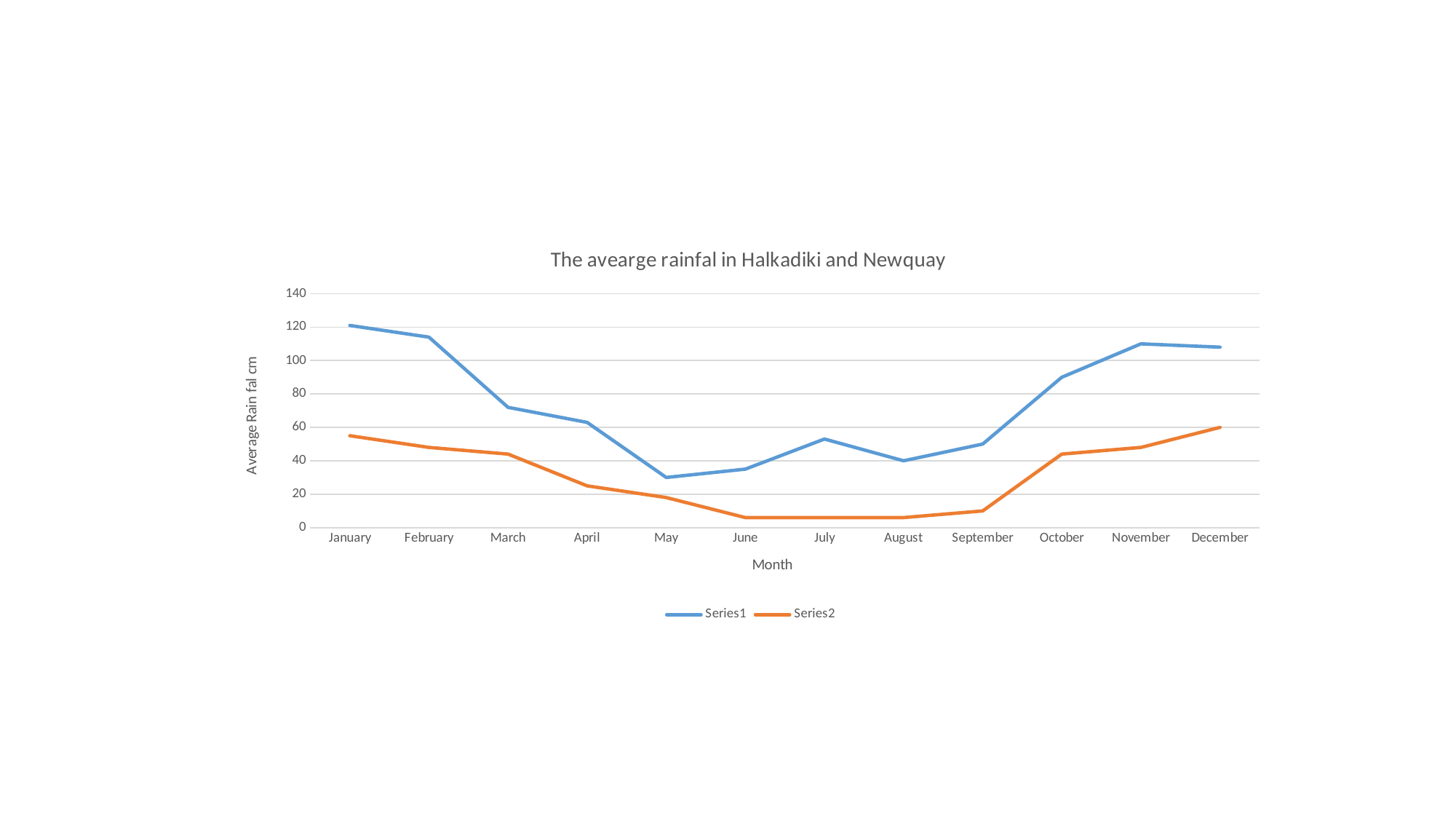
Is the value for Series2 in June greater or less than 20? less In which month does Series1 reach its lowest value? May Is the value for Series1 in May greater or less than 40? less What kind of chart is shown on the slide? line chart In which month does Series1 reach its highest value? January How many series does the legend list? 2 In which month does Series2 reach its highest value? December What is the title of the chart? The avearge rainfal in Halkadiki and Newquay Which series has the larger value in January, Series1 or Series2? Series1 How many months are plotted along the x axis? 12 Is the value for Series1 in January greater or less than 100? greater Does Series1 rise or fall from January to May? fall